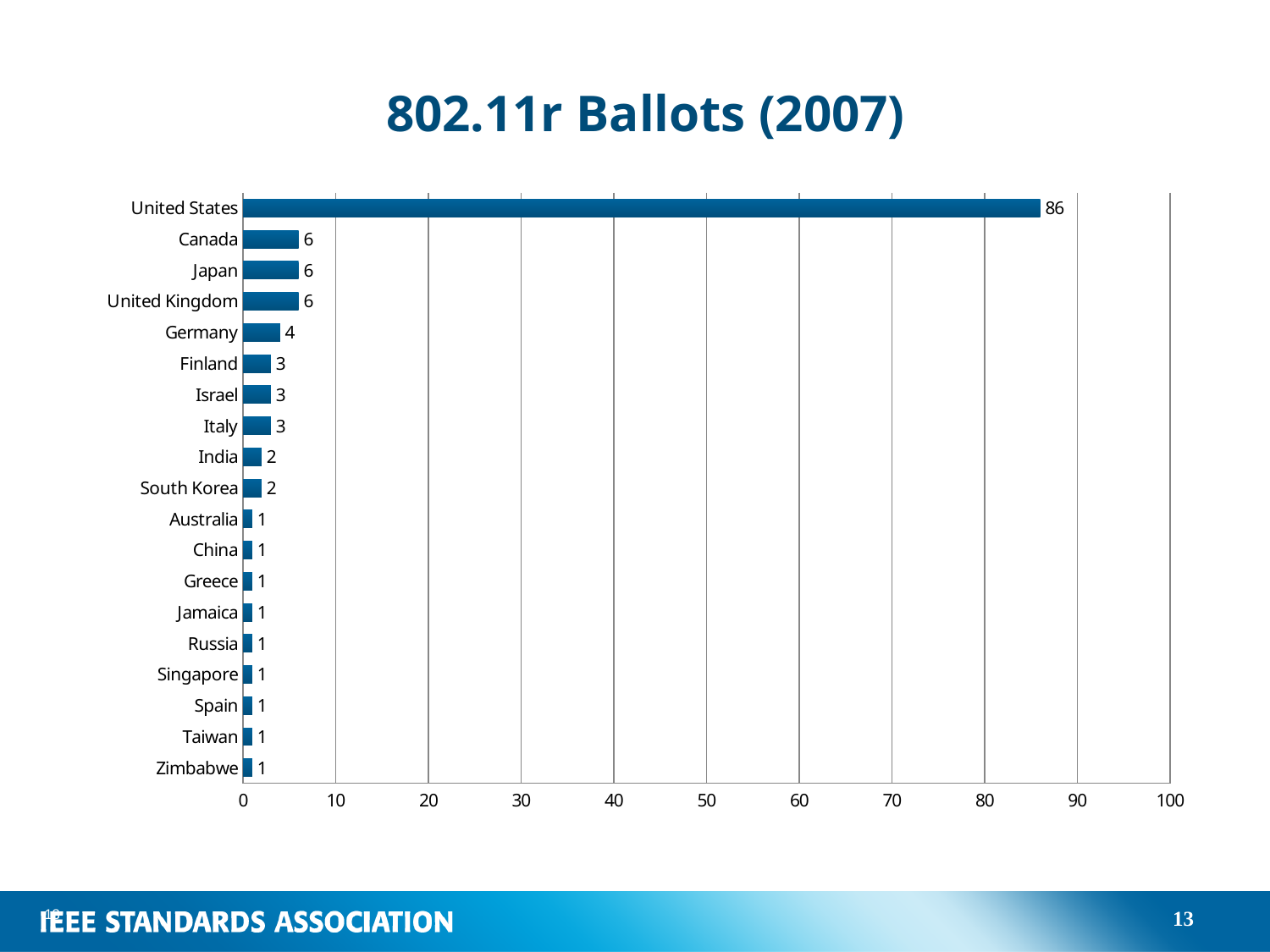
What is the difference between the values for United States and Canada? 80 What is the difference between the values for Germany and India? 2 How many countries are shown on the chart? 19 Is the value for United States greater or less than 80? greater What kind of chart is shown on the slide? bar chart Which is larger, the value for Finland or the value for Australia? Finland What is the value for South Korea? 2 Which country has the highest number of ballots? United States What is the value for Japan? 6 What is the value for Germany? 4 What is the title of the chart? 802.11r Ballots (2007) What is the value for United States? 86